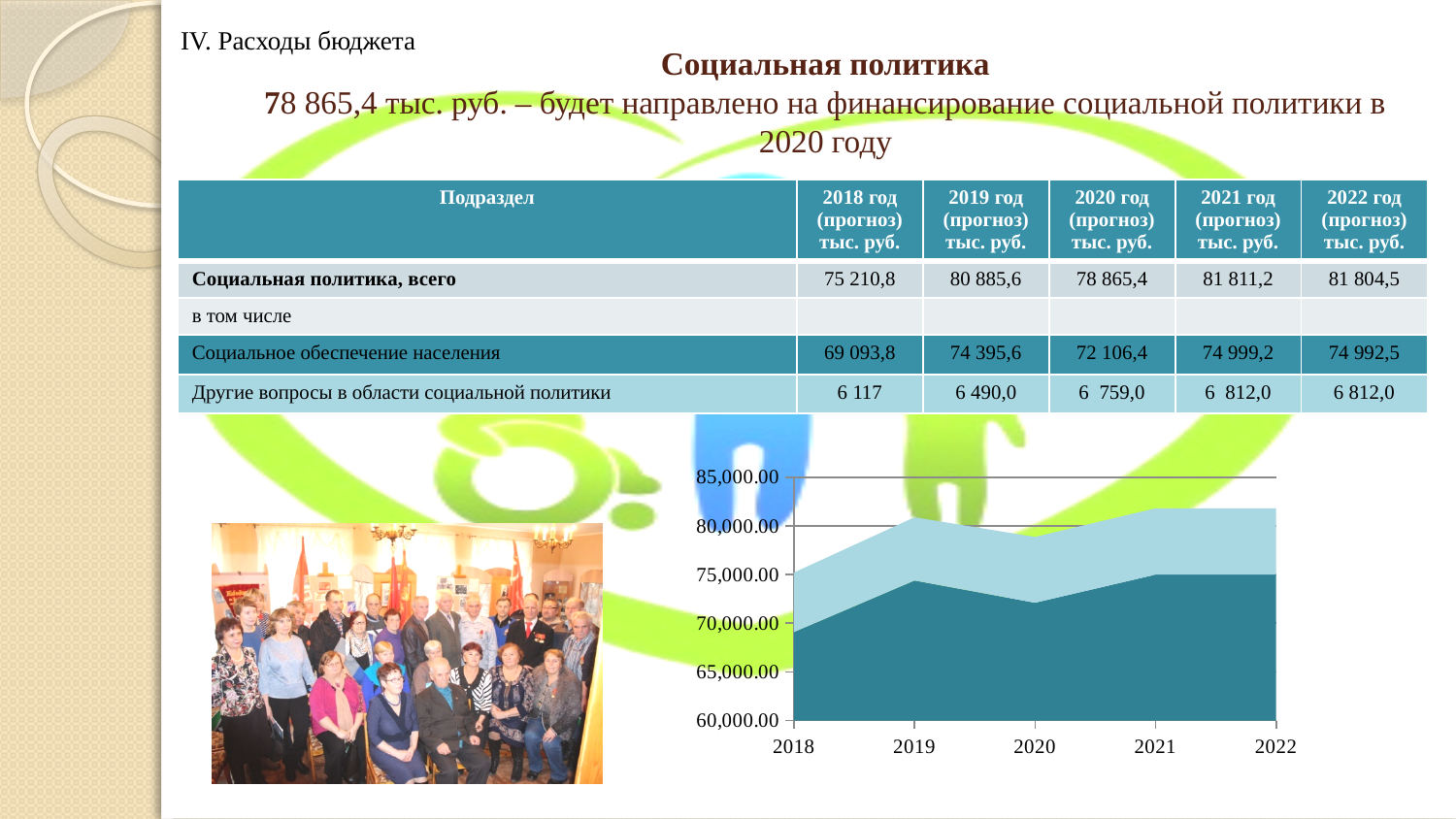
How many data series are plotted in the area chart? 2 Does the dark teal (lower) series rise or fall from 2019 to 2020? fall How many years are shown along the x axis of the chart? 5 What is the highest value shown on the chart's y axis? 85,000.00 What kind of chart is shown on the slide? area chart Which year has the larger value for the dark teal (lower) series, 2019 or 2020? 2019 In which year is the dark teal (lower) series at its lowest? 2018 Is the top of the stacked area for 2020 greater or less than 75,000? greater In which year is the total height of the stacked area lowest? 2018 Is the top of the stacked area for 2020 greater or less than 80,000? less Is the top of the stacked area for 2021 greater or less than 80,000? greater